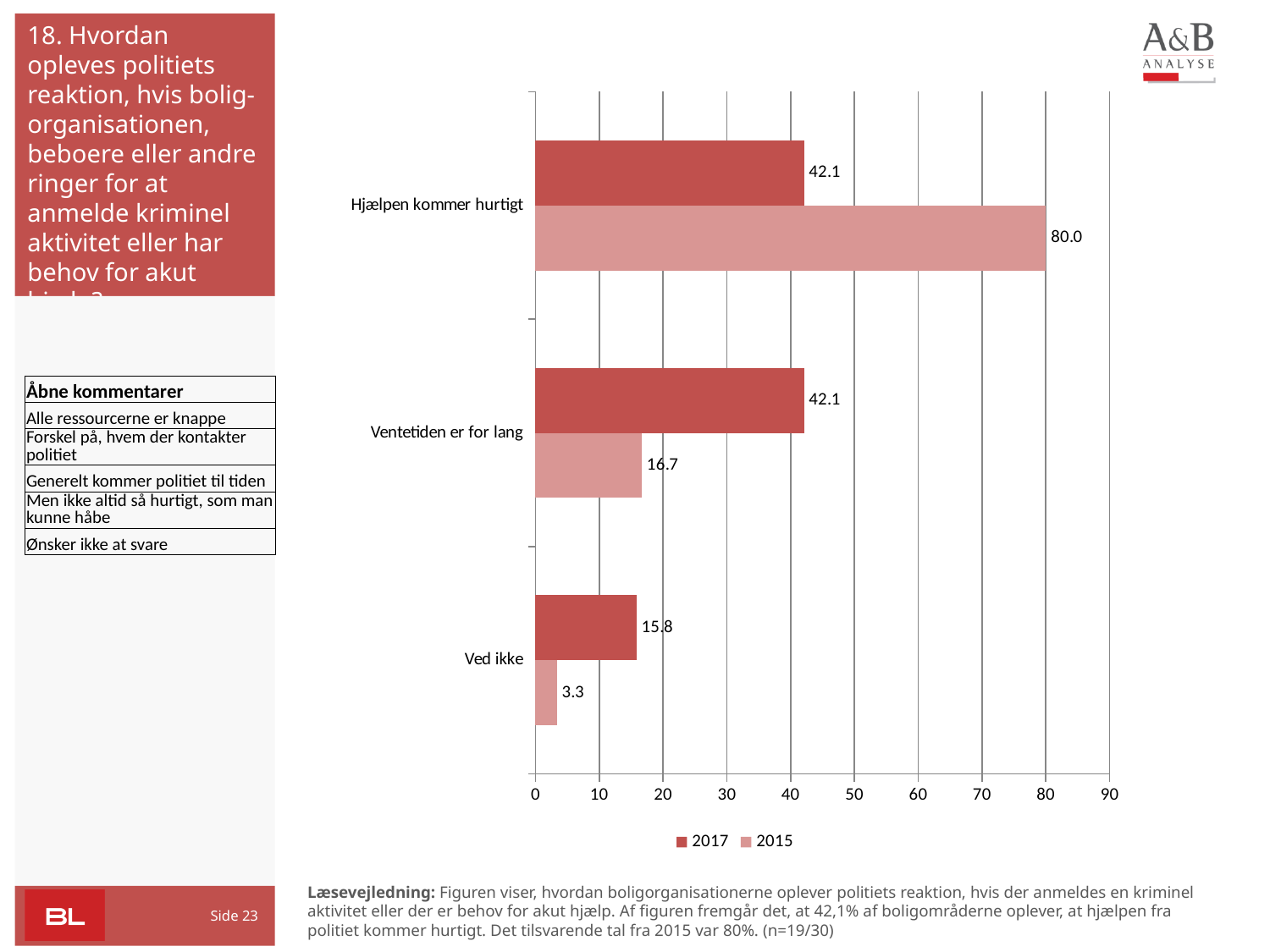
What is the 2015 value for "Ved ikke"? 3.3 Which category has the highest 2015 value? Hjælpen kommer hurtigt Is the 2017 value for "Ved ikke" greater or less than 20? less What is the 2015 value for "Hjælpen kommer hurtigt"? 80.0 How many categories are shown on the chart? 3 How many series does the legend list? 2 Which category has the lowest 2017 value? Ved ikke What is the 2017 value for "Ventetiden er for lang"? 42.1 Which series is shown in the darker red colour? 2017 For "Ventetiden er for lang", which is larger: the 2017 value or the 2015 value? 2017 What is the difference between the 2015 and 2017 values for "Hjælpen kommer hurtigt"? 37.9 What kind of chart is shown on the slide? Bar chart